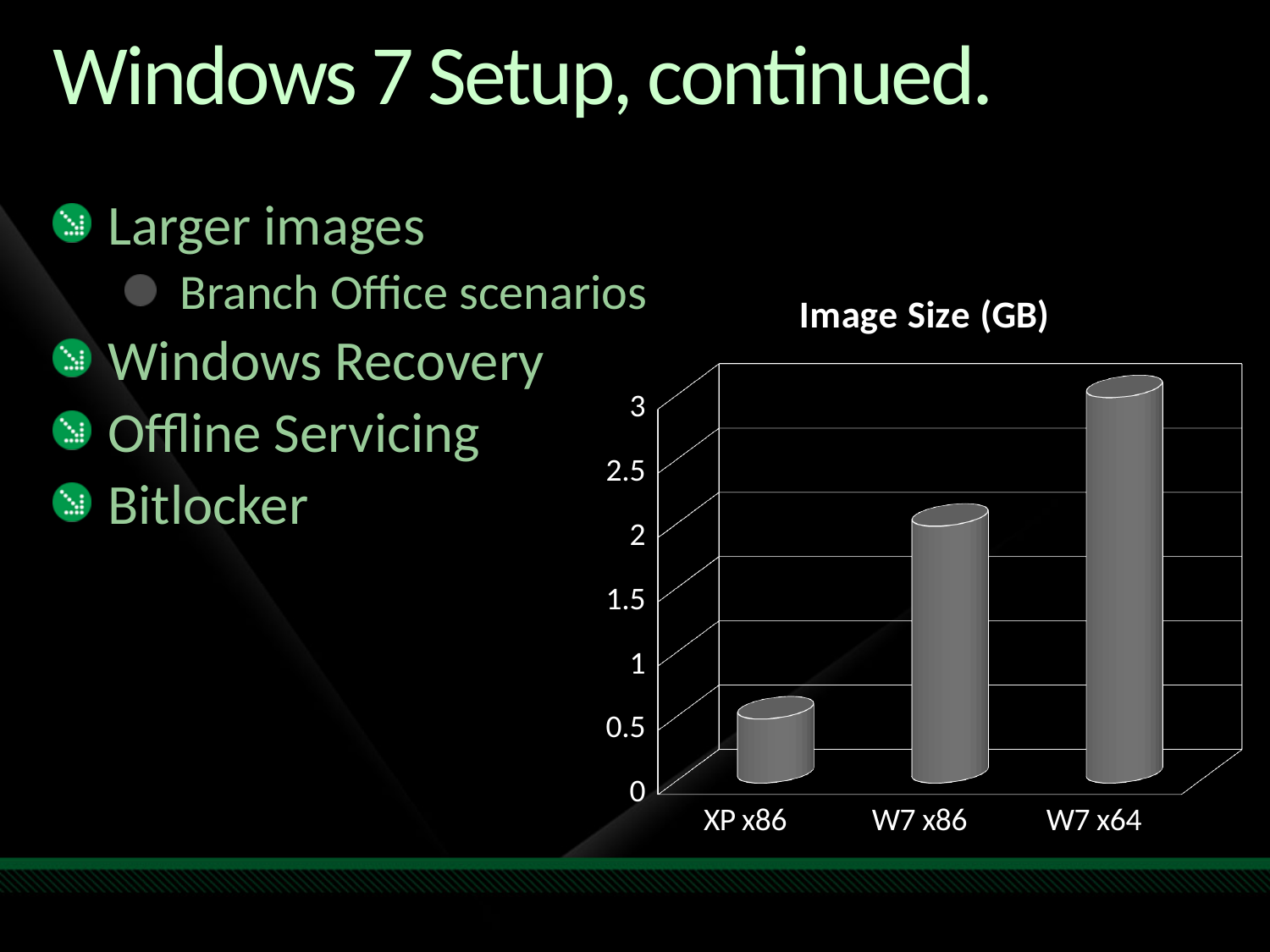
Which category has the largest image size? W7 x64 Do the values rise or fall from XP x86 to W7 x64 along the x axis? rise What kind of chart is shown on the slide? bar chart Which is larger, the image size for W7 x64 or for W7 x86? W7 x64 How many categories are shown on the chart's x axis? 3 Is the value for W7 x64 greater or less than 2.5? greater What is the highest tick value shown on the chart's vertical axis? 3 Is the value for XP x86 greater or less than 1? less What is the title of the chart? Image Size (GB) Is the value for W7 x86 greater or less than 1.5? greater Which is larger, the image size for W7 x86 or for XP x86? W7 x86 Which category has the smallest image size? XP x86